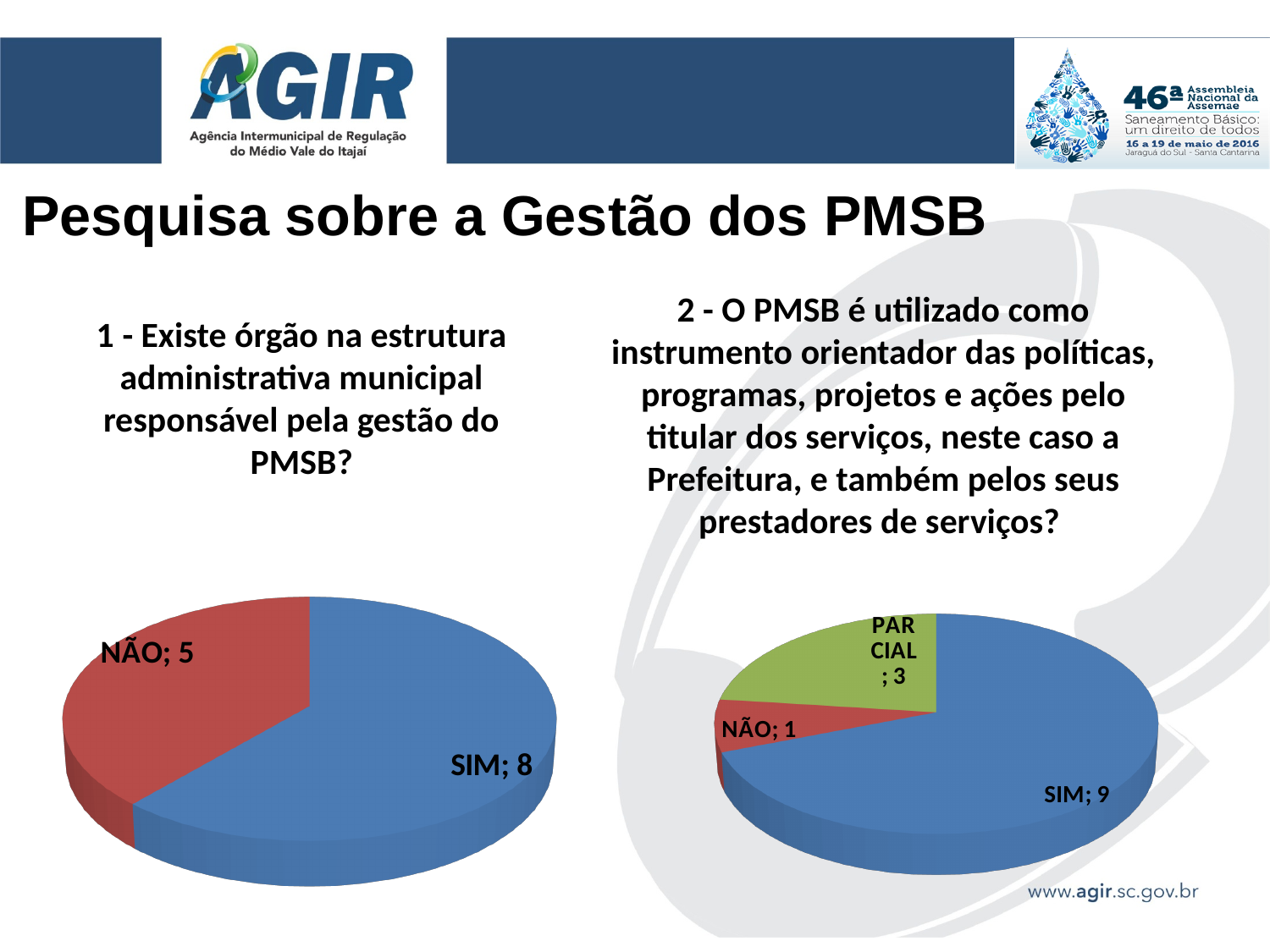
In the right chart (question 2), what is the value for PARCIAL? 3 In the left chart (question 1), what is the difference between the SIM and NÃO values? 3 In the right chart (question 2), which category has the smallest slice? NÃO In the right chart (question 2), is the SIM slice larger or smaller than the PARCIAL slice? larger What type of chart is used for question 1 on the left? pie chart In the right chart (question 2), what is the total of all slices? 13 In the left chart (question 1), how many respondents answered SIM? 8 How many slices does the right chart (question 2) have? 3 In the right chart (question 2), what is the value for NÃO? 1 In the right chart (question 2), which category has the largest slice? SIM In the left chart (question 1), what colour is the SIM slice? blue In the left chart (question 1), how many respondents answered NÃO? 5